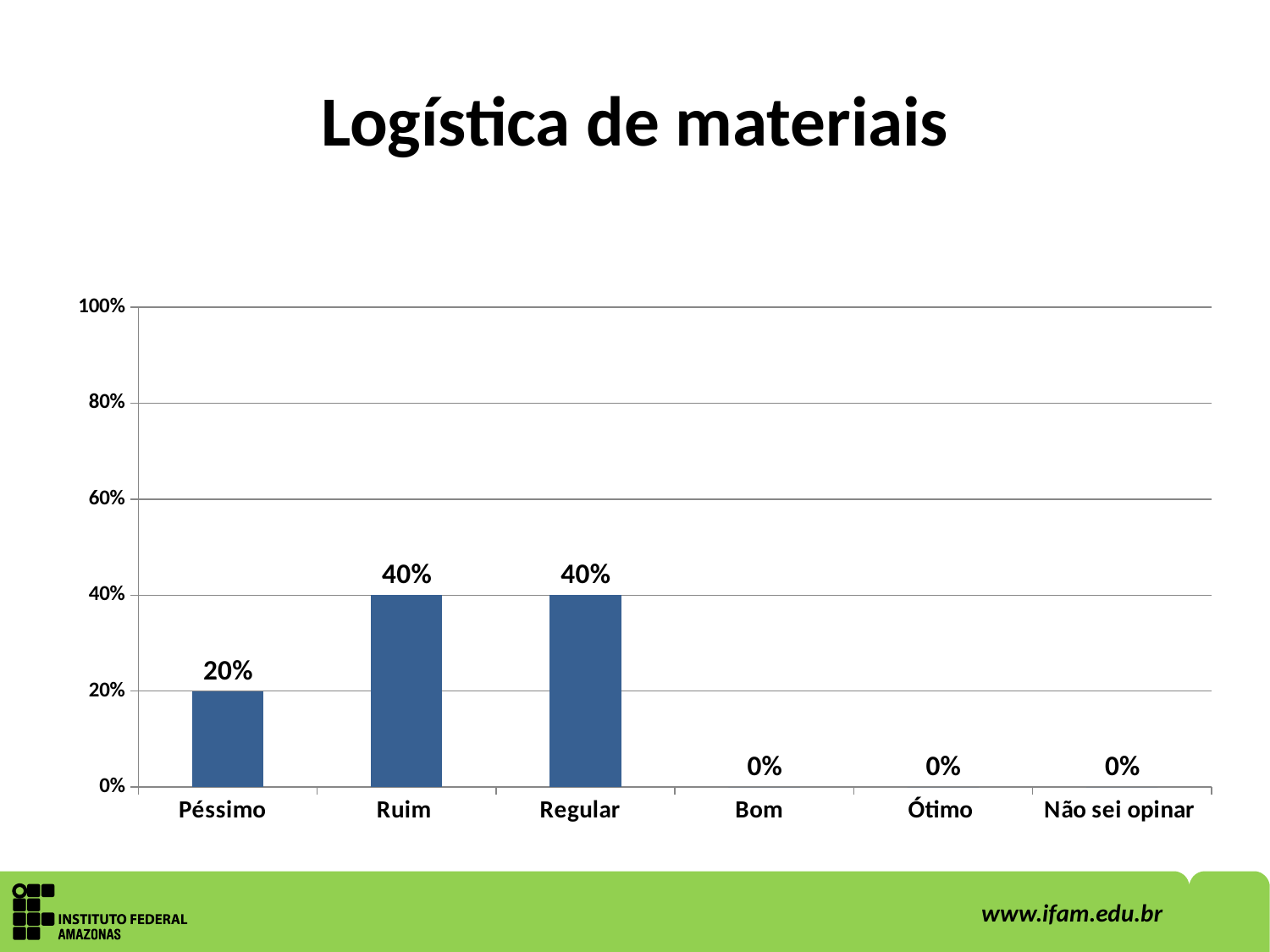
What is the value for Não sei opinar? 0% Which is larger, the value for Regular or the value for Péssimo? Regular What is the title of the slide? Logística de materiais Is the value for Ruim greater or less than 60%? less How many categories are shown on the x axis? 6 Which category has the lowest non-zero value? Péssimo What kind of chart is shown on the slide? bar chart How many categories have a value of 0%? 3 What is the difference between the values for Ruim and Péssimo? 20% What is the value for Péssimo? 20% What is the value for Ruim? 40% What is the value for Bom? 0%